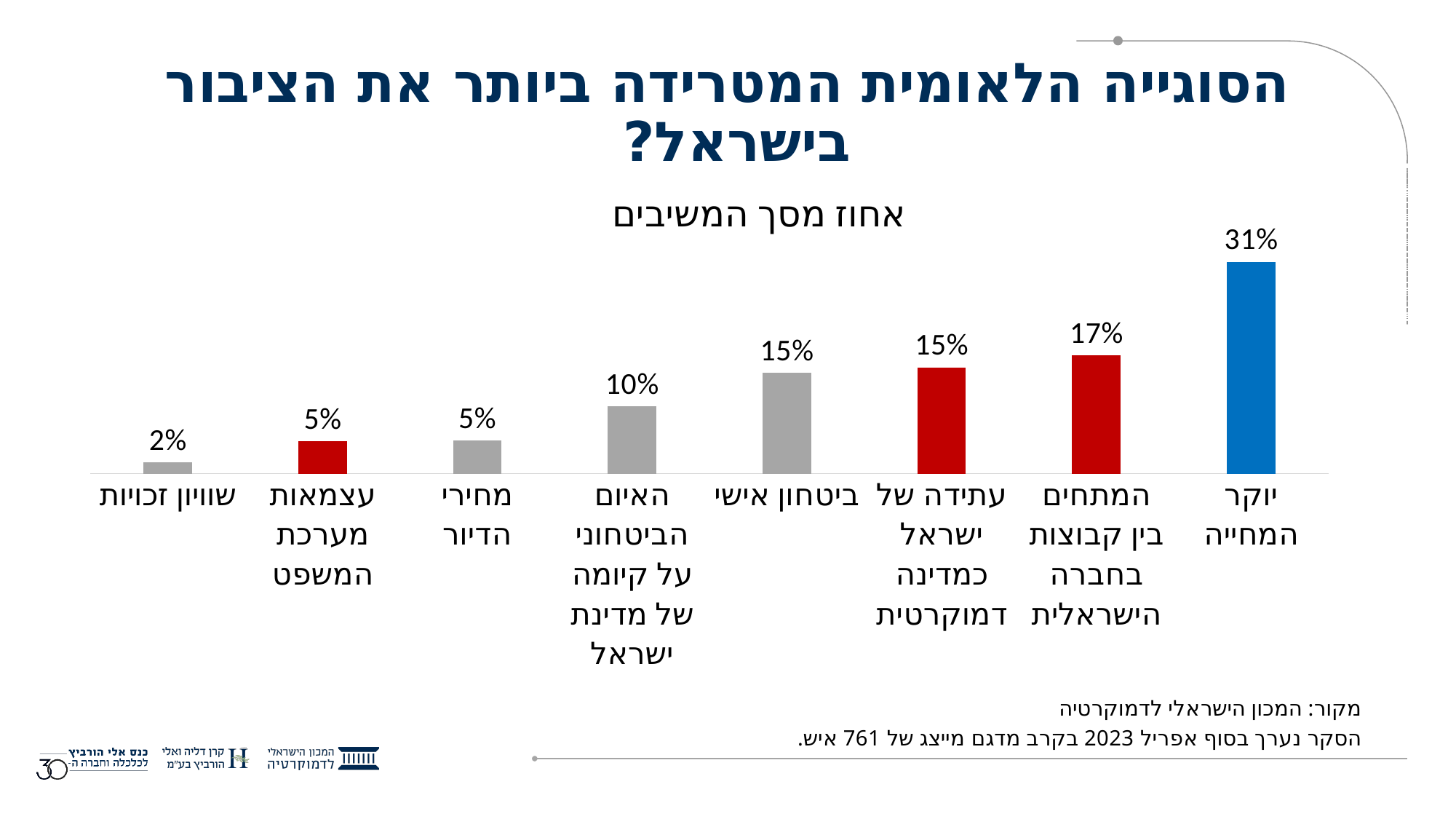
What is the subtitle shown above the chart? אחוז מסך המשיבים What type of chart is shown on the slide? Bar chart Which is larger: the value for ביטחון אישי or the value for מחירי הדיור? ביטחון אישי What is the value shown for המתחים בין קבוצות בחברה הישראלית (tensions between groups in Israeli society)? 17% Which category has the lowest value in the chart? שוויון זכויות What is the value shown for שוויון זכויות (equal rights)? 2% What colour is the bar for יוקר המחייה? Blue What percentage of respondents chose יוקר המחייה (cost of living) as the most troubling national issue? 31% Which category has the highest value in the chart? יוקר המחייה How many categories are shown in the chart? 8 What is the difference between the values for יוקר המחייה and המתחים בין קבוצות בחברה הישראלית? 14% What is the value shown for האיום הביטחוני על קיומה של מדינת ישראל (the security threat to Israel's existence)? 10%